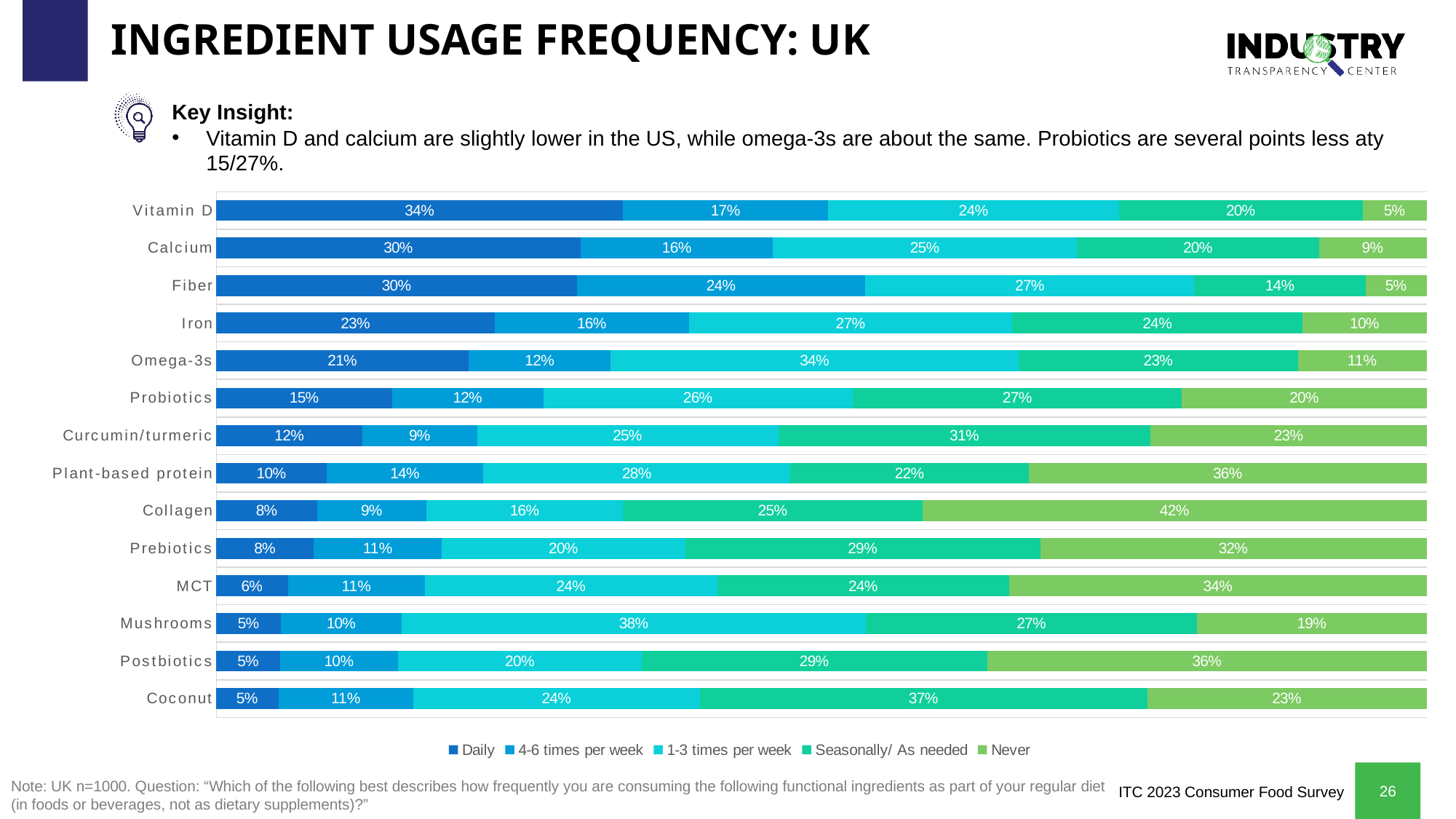
How many series does the legend list? 5 Which has a larger Never value, Collagen or Plant-based protein? Collagen What is the 1-3 times per week value for Omega-3s? 34% What is the Daily value for Vitamin D? 34% What kind of chart is shown on the slide? Stacked bar chart Which ingredient has the highest Daily value? Vitamin D Which ingredient has the highest Never value? Collagen How many ingredients (categories) are listed on the chart? 14 Which ingredient has the highest 1-3 times per week value? Mushrooms What is the total of the stacked bar for Vitamin D? 100% What is the Seasonally/ As needed value for Probiotics? 27% What is the difference between the Daily value for Vitamin D and the Daily value for Coconut? 29 percentage points